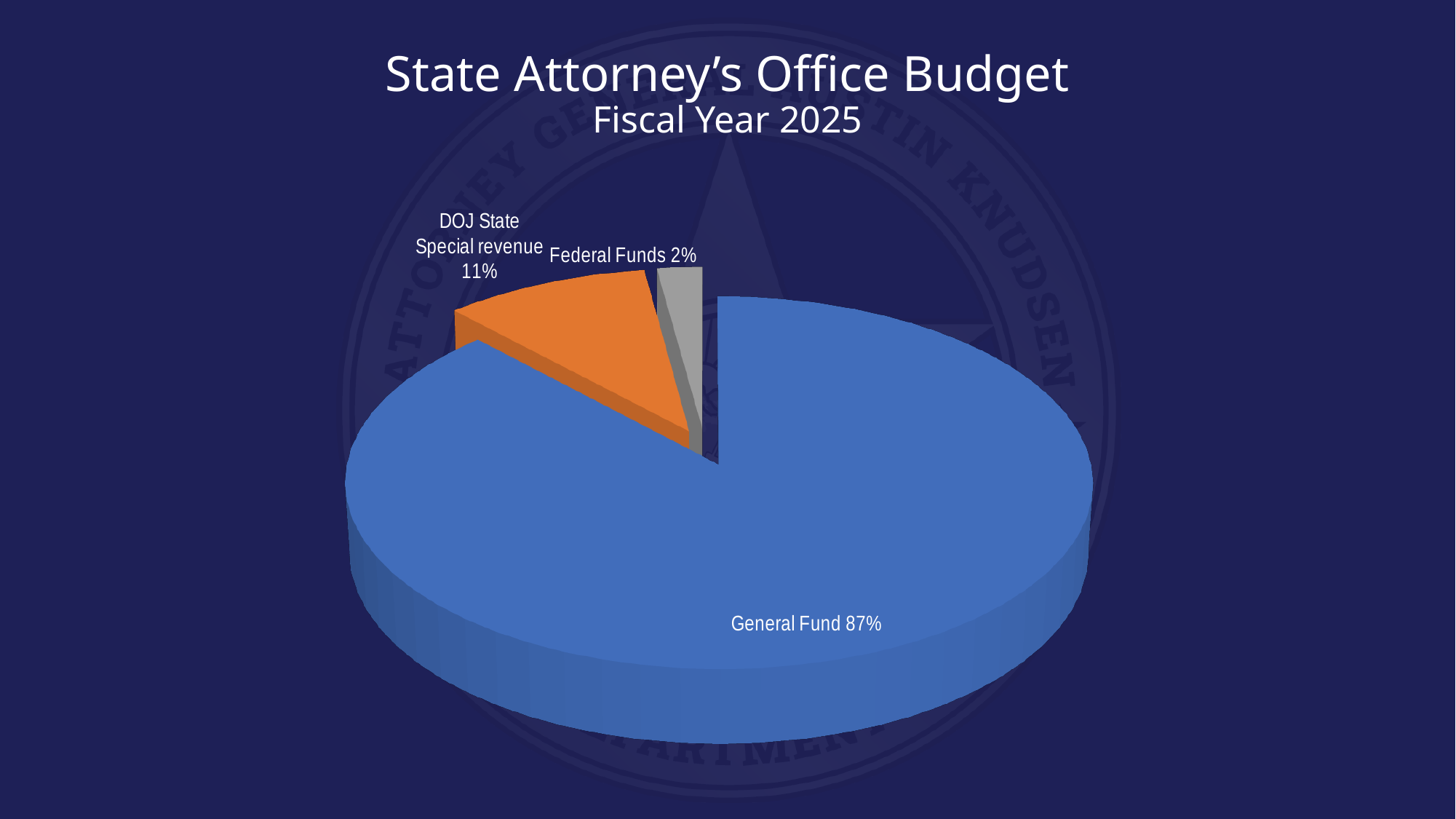
What colour is the General Fund slice? Blue What kind of chart is shown on the slide? Pie chart What is the difference in percentage points between the General Fund and DOJ State Special revenue slices? 76 Which slice of the pie is the smallest? Federal Funds What share of the budget does the Federal Funds slice represent? 2% What is the difference in percentage points between the DOJ State Special revenue and Federal Funds slices? 9 What share of the budget does the General Fund slice represent? 87% What is the title of the chart? State Attorney's Office Budget Fiscal Year 2025 Which slice of the pie is the largest? General Fund Which is larger, the DOJ State Special revenue slice or the Federal Funds slice? DOJ State Special revenue How many slices does the pie chart have? 3 What share of the budget does the DOJ State Special revenue slice represent? 11%